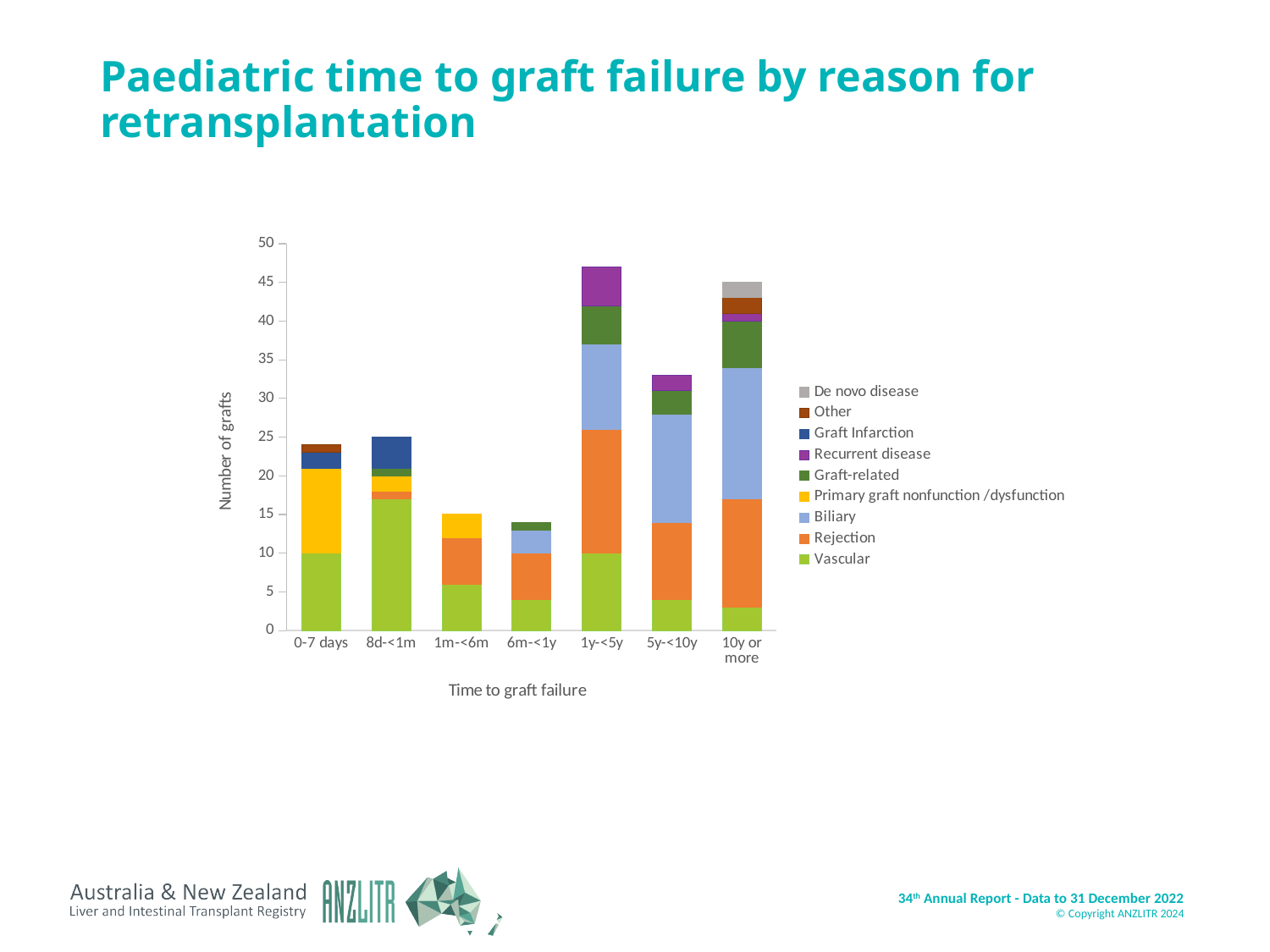
What kind of chart is shown on the slide? bar chart Is the total number of grafts for 1y-<5y greater or less than 40? greater Which has a larger total number of grafts, 5y-<10y or 10y or more? 10y or more How many time-to-graft-failure categories are shown on the x axis? 7 What is the title of the y axis? Number of grafts Which time-to-graft-failure category has the highest total number of grafts? 1y-<5y How many series does the legend list? 9 Is the total number of grafts for 6m-<1y greater or less than 20? less Which has a larger total number of grafts, 0-7 days or 1m-<6m? 0-7 days What is the title of the x axis? Time to graft failure Is the total number of grafts for 0-7 days greater or less than 20? greater